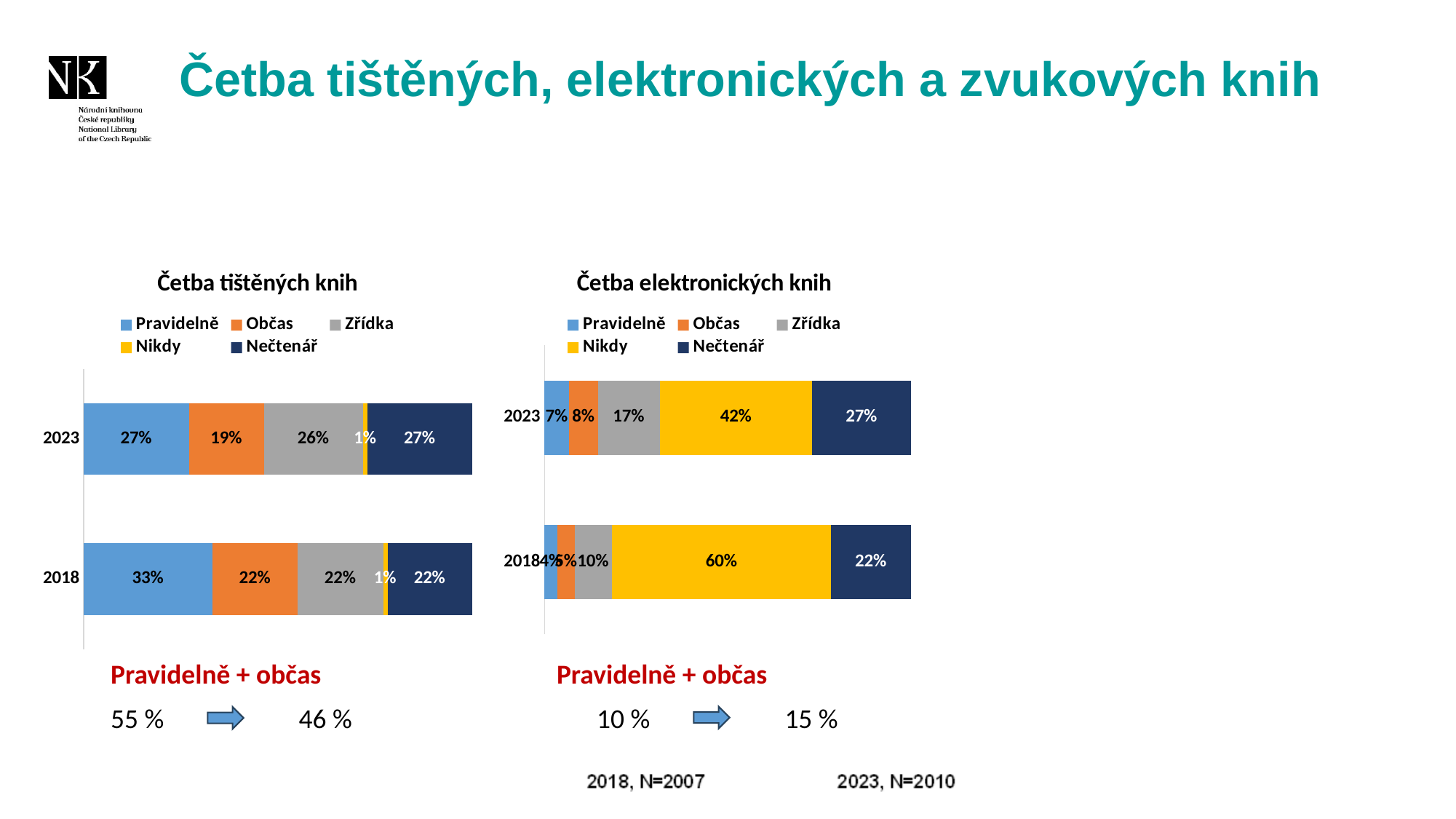
In the chart titled "Četba tištěných knih", what is the value for Občas in 2018? 22% What kind of chart is the chart titled "Četba tištěných knih"? Stacked bar chart In the chart titled "Četba elektronických knih", what is the value for Nečtenář in 2023? 27% In the chart titled "Četba elektronických knih", what is the value for Nikdy in 2023? 42% In the chart titled "Četba tištěných knih", what is the difference between the Pravidelně values for 2018 and 2023? 6% In the chart titled "Četba tištěných knih", which series has the largest value in 2018? Pravidelně In the chart titled "Četba elektronických knih", is the Nikdy value larger in 2018 or in 2023? 2018 In the chart titled "Četba elektronických knih", what is the value for Nikdy in 2018? 60% How many series does the legend of the chart titled "Četba tištěných knih" list? 5 In the chart titled "Četba tištěných knih", what is the value for Pravidelně in 2023? 27% In the chart titled "Četba elektronických knih", which series has the smallest value in 2023? Pravidelně How many categories (years) are shown in the chart titled "Četba elektronických knih"? 2